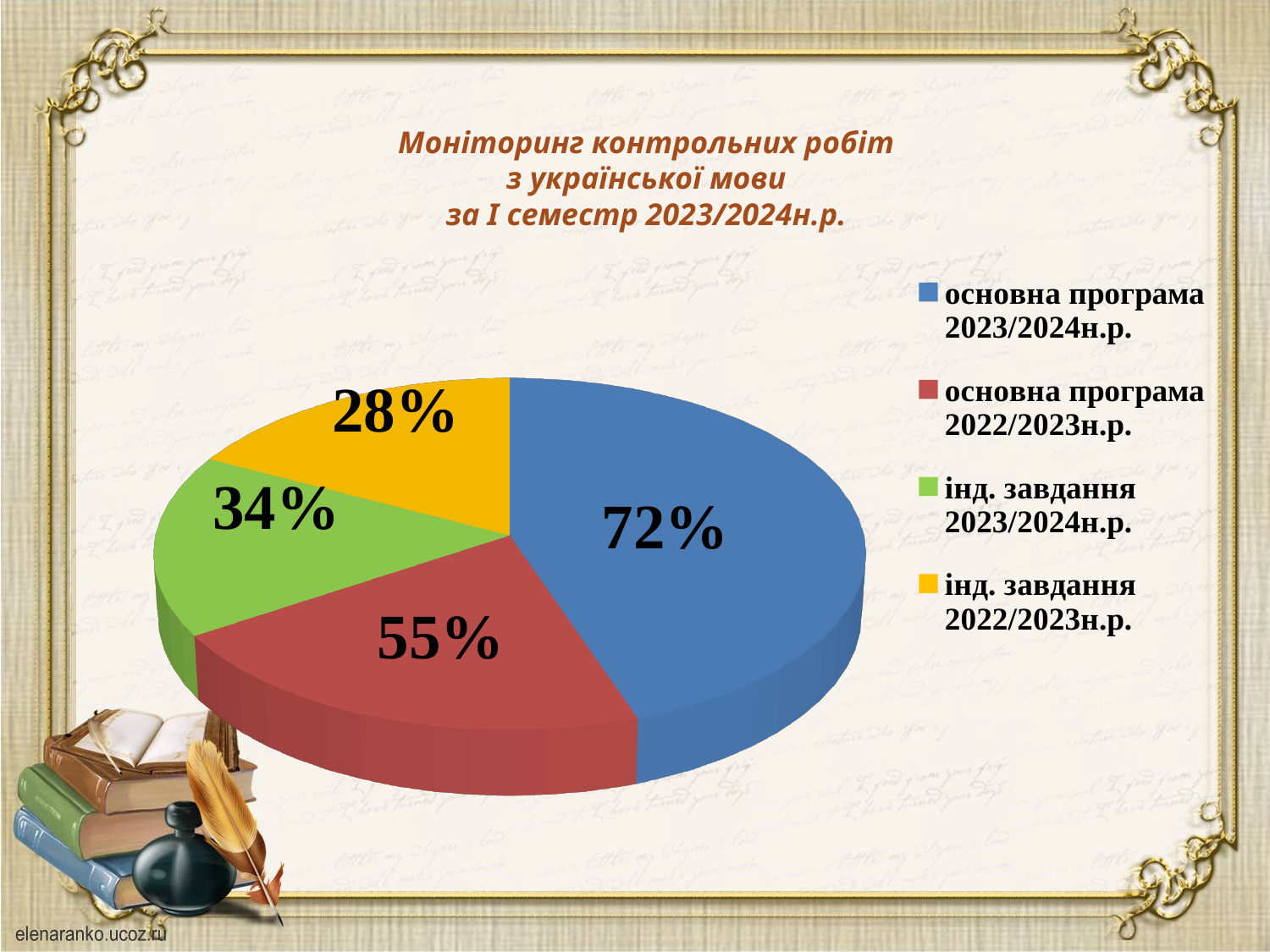
What value is shown for "інд. завдання 2022/2023н.р."? 28% What type of chart is shown on the slide? pie chart What value is shown for "основна програма 2022/2023н.р."? 55% Which is larger: the value for "основна програма 2022/2023н.р." or the value for "інд. завдання 2023/2024н.р."? основна програма 2022/2023н.р. What is the difference between the values for "основна програма 2023/2024н.р." and "основна програма 2022/2023н.р."? 17% Which category has the lowest value in the pie chart? інд. завдання 2022/2023н.р. What value is shown for "основна програма 2023/2024н.р."? 72% What is the difference between the values for "інд. завдання 2023/2024н.р." and "інд. завдання 2022/2023н.р."? 6% Which colour represents "інд. завдання 2022/2023н.р." in the legend? yellow What value is shown for "інд. завдання 2023/2024н.р."? 34% Which category has the highest value in the pie chart? основна програма 2023/2024н.р. How many slices does the pie chart have? 4